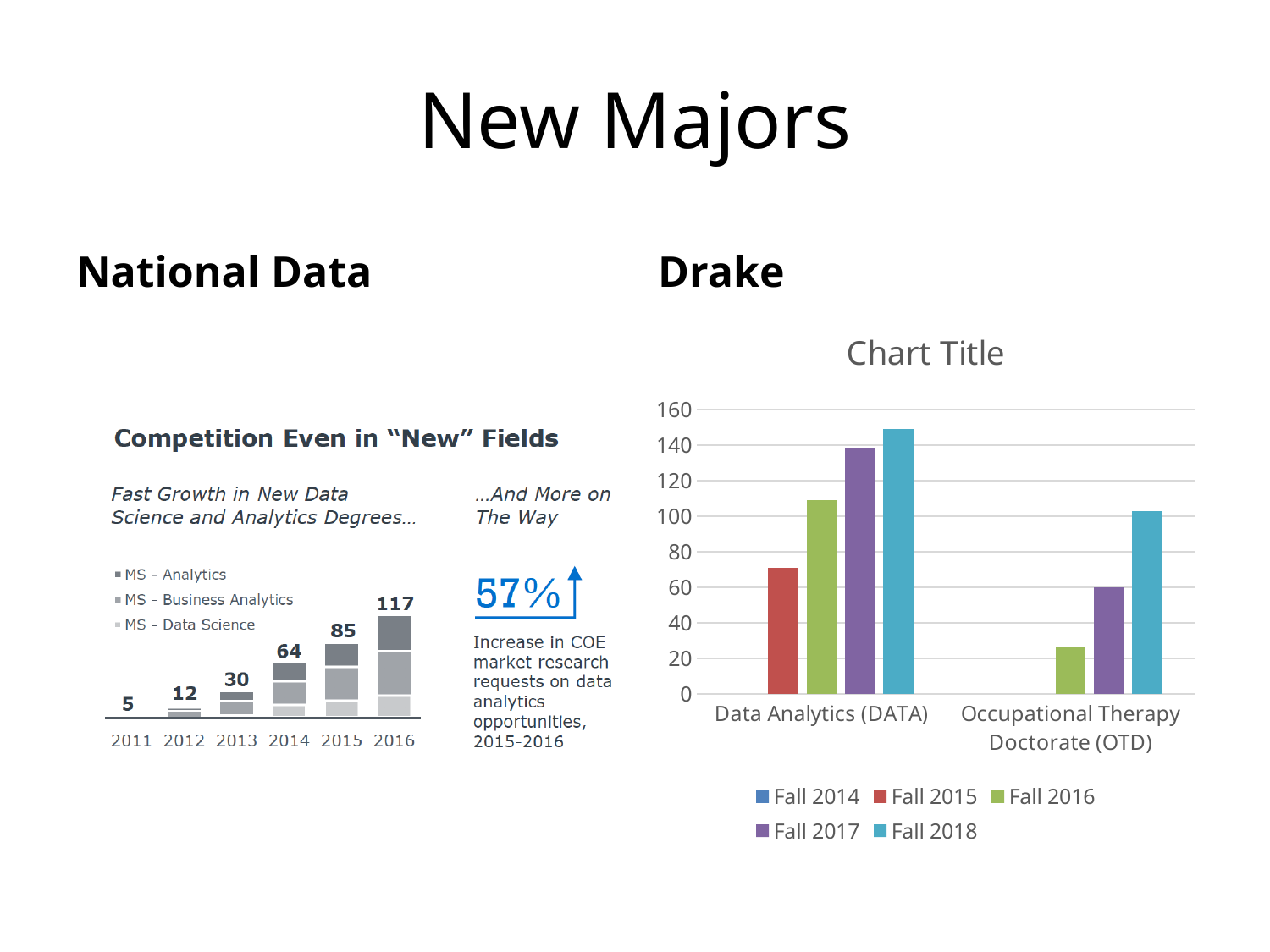
In the chart titled "Competition Even in "New" Fields" on the left, what is the total for 2016? 117 In the chart titled "Chart Title" on the right, how many series does the legend list? 5 In the chart titled "Chart Title" on the right, which series has the highest value for Occupational Therapy Doctorate (OTD)? Fall 2018 In the chart titled "Chart Title" on the right, which is larger for Fall 2017: Data Analytics (DATA) or Occupational Therapy Doctorate (OTD)? Data Analytics (DATA) In the chart titled "Chart Title" on the right, is the Fall 2015 value for Data Analytics (DATA) greater or less than 80? less What kind of chart is the chart titled "Chart Title" on the right? bar chart In the chart titled "Chart Title" on the right, is the Fall 2018 value for Data Analytics (DATA) greater or less than 140? greater In the chart titled "Chart Title" on the right, is the Fall 2016 value for Occupational Therapy Doctorate (OTD) greater or less than 40? less In the chart titled "Competition Even in "New" Fields" on the left, what is the difference between the 2015 total and the 2014 total? 21 In the chart titled "Chart Title" on the right, how many categories are shown on the x axis? 2 In the chart titled "Competition Even in "New" Fields" on the left, which year has the lowest total? 2011 In the chart titled "Chart Title" on the right, do the Data Analytics (DATA) values rise or fall from Fall 2015 to Fall 2018? rise